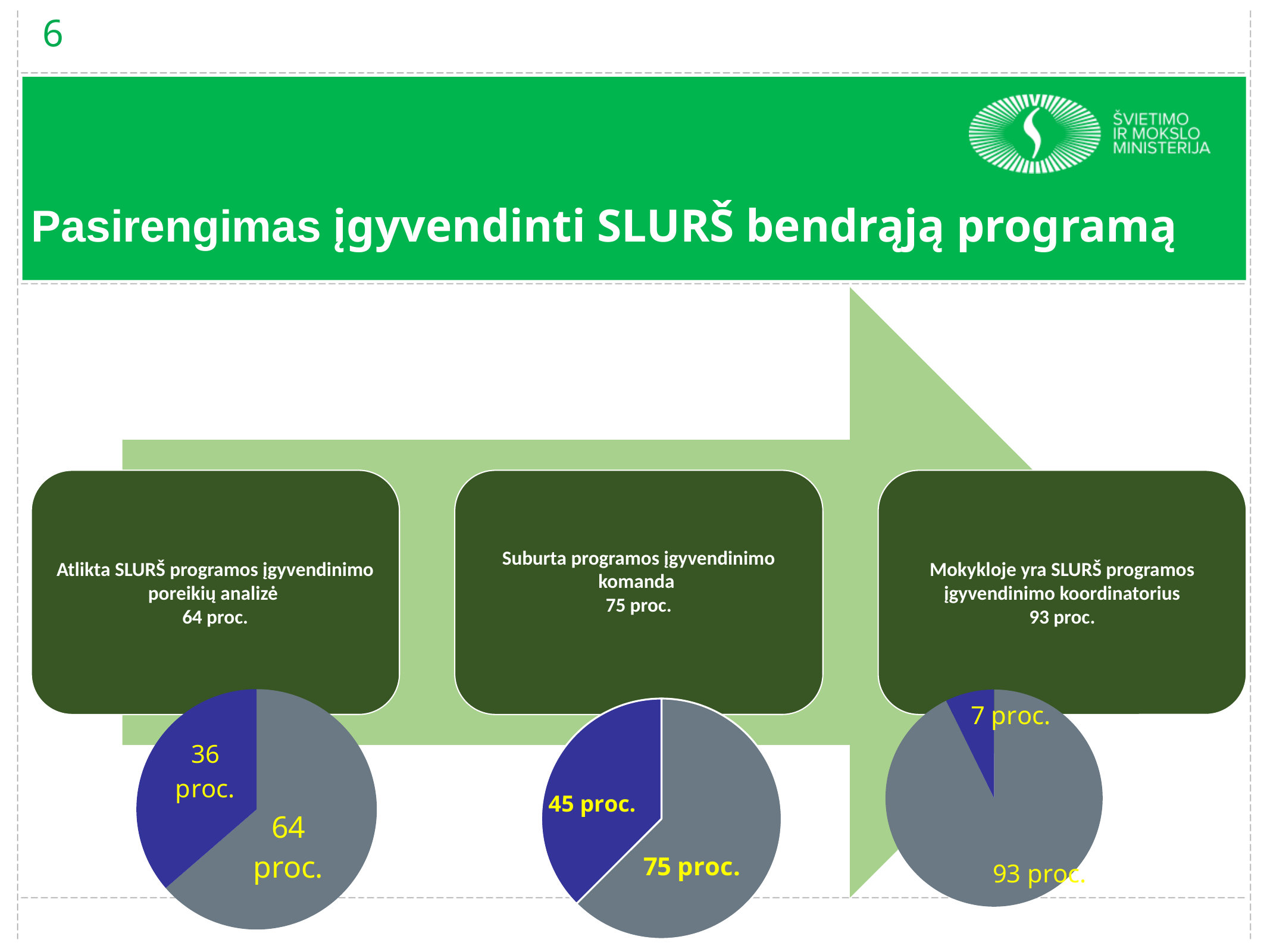
In the left pie chart, which slice is larger, the blue one or the grey one? the grey one How many slices does each pie chart on the slide have? 2 In the left pie chart, what value is printed on the grey slice? 64 proc. Across the three pie charts, which chart has the smallest blue slice? the right chart In the left pie chart, what is the difference between the grey slice value and the blue slice value? 28 proc. In the right pie chart, what value is printed on the blue slice? 7 proc. In the middle pie chart, what value is printed on the grey slice? 75 proc. In the middle pie chart, what value is printed on the blue slice? 45 proc. In the left pie chart, what value is printed on the blue slice? 36 proc. In the right pie chart, what value is printed on the grey slice? 93 proc. How many pie charts are shown on the slide? 3 What kind of chart is the left chart on the slide? pie chart